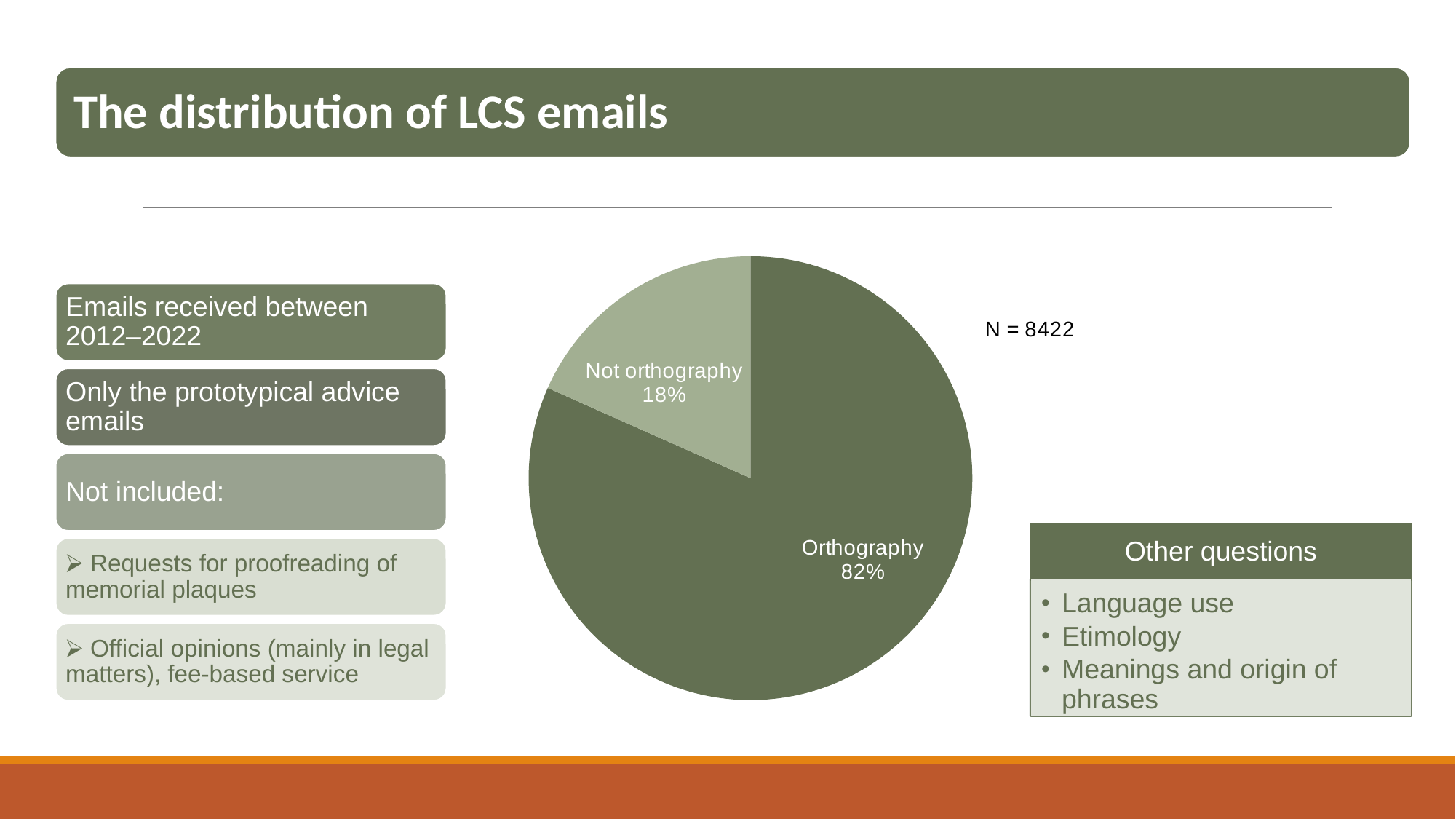
What kind of chart is shown on the slide? pie chart What is the title of the slide containing the pie chart? The distribution of LCS emails How many slices does the pie chart have? 2 Which slice of the pie is the smallest? Not orthography What is the total number of emails (N) stated next to the pie chart? 8422 What share of the pie does Not orthography account for? 18% Which slice of the pie is the largest? Orthography What share of the pie does Orthography account for? 82% What is the difference in percentage points between the Orthography and Not orthography slices? 64 Which is larger, the Orthography slice or the Not orthography slice? Orthography